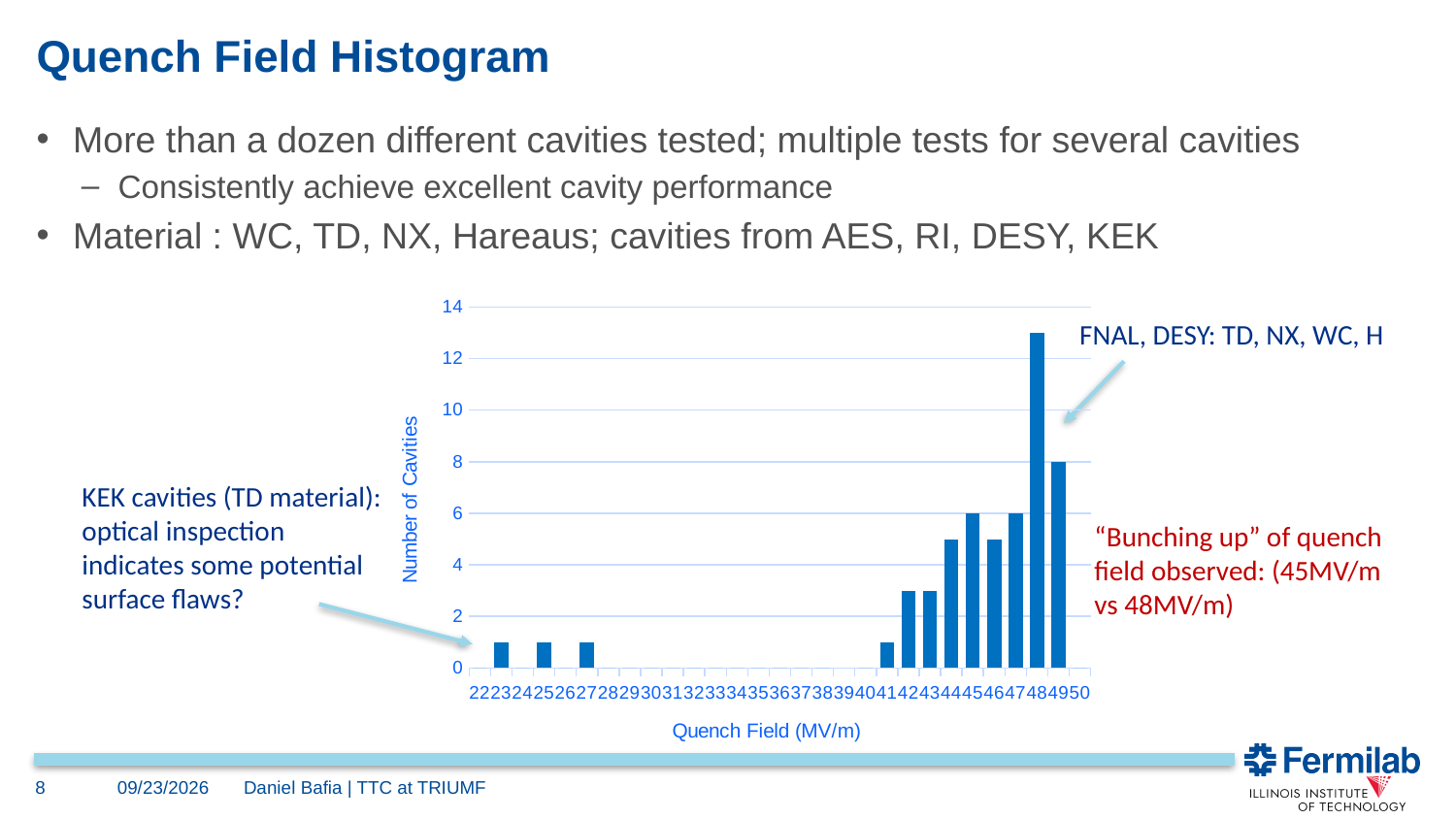
How many bars are plotted in the histogram? 12 How many cavities are recorded at a quench field of 47 MV/m? 6 How many cavities are recorded at a quench field of 45 MV/m? 6 Which has more cavities: a quench field of 48 MV/m or 49 MV/m? 48 MV/m How many cavities are recorded at a quench field of 49 MV/m? 8 What is the title of the y axis of the chart? Number of Cavities Is the number of cavities at a quench field of 48 MV/m greater or less than 12? greater At which quench field value is the number of cavities highest? 48 Is the number of cavities at a quench field of 44 MV/m greater or less than 4? greater What kind of chart is shown on the slide? bar chart What is the title of the x axis of the chart? Quench Field (MV/m) Is the number of cavities at a quench field of 49 MV/m greater or less than 10? less